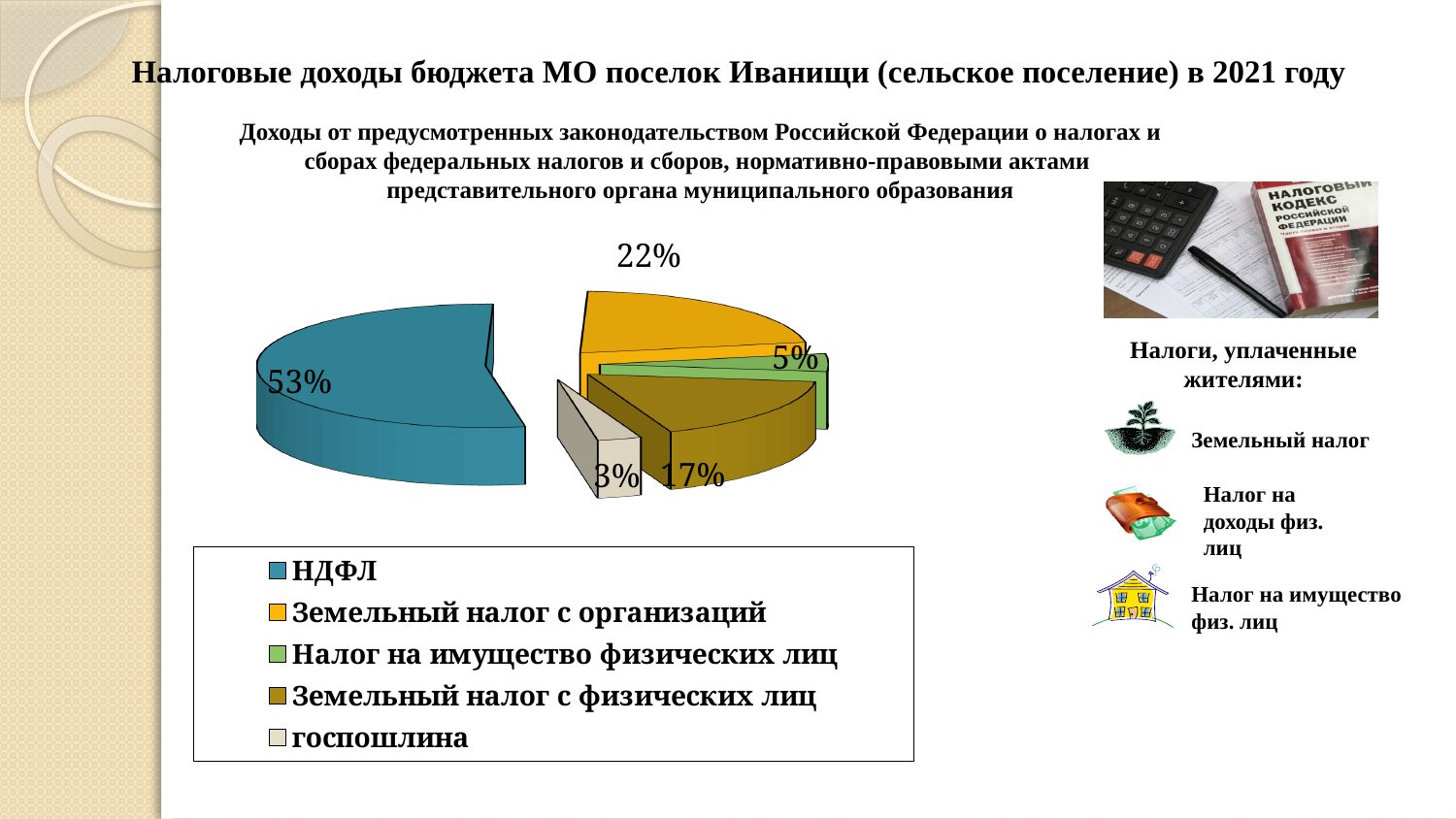
Which is larger: the share for Земельный налог с физических лиц or the share for Налог на имущество физических лиц? Земельный налог с физических лиц Which colour represents НДФЛ in the legend? blue Which category has the smallest share of the pie? госпошлина What share of the pie does Земельный налог с организаций have? 22% What share of the pie does НДФЛ have? 53% Which category has the largest share of the pie? НДФЛ What share of the pie does Земельный налог с физических лиц have? 17% What share of the pie does госпошлина have? 3% What kind of chart is shown on the slide? pie chart How many categories does the pie chart have? 5 What is the difference in percentage points between НДФЛ and Земельный налог с организаций? 31 What share of the pie does Налог на имущество физических лиц have? 5%